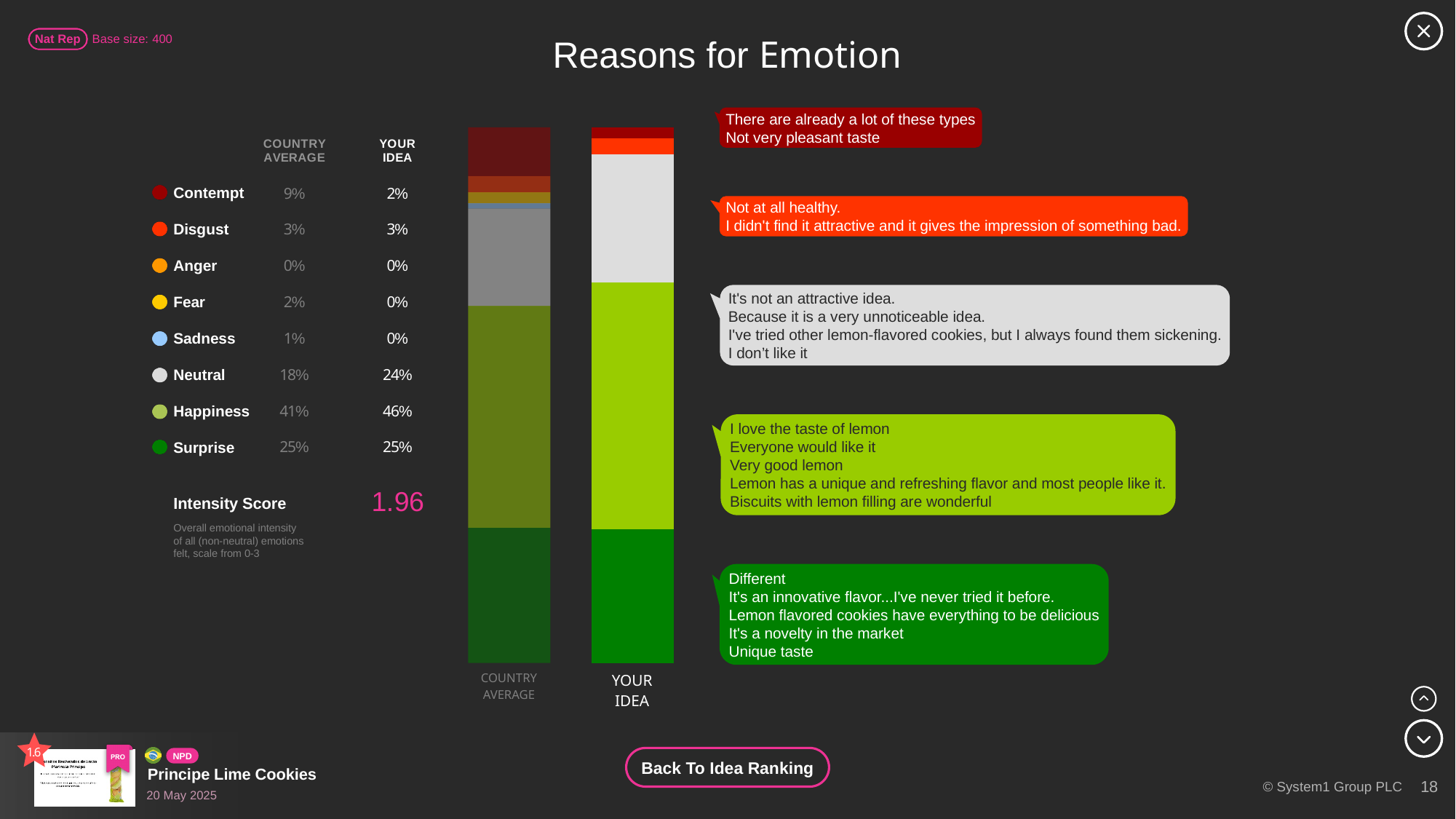
What is the Neutral value for the Country Average? 18% How many emotion categories are listed in the chart? 8 Which emotion has the highest value for Your Idea? Happiness What percentage of respondents felt Happiness for Your Idea? 46% What kind of chart is shown on the slide? Stacked bar chart How many stacked bars are shown in the chart? 2 What is the difference between the Neutral value for Your Idea and the Country Average? 6 percentage points What is the Intensity Score shown on the slide? 1.96 Is the Happiness value larger for Your Idea or for the Country Average? Your Idea Is the Contempt value larger for the Country Average or for Your Idea? Country Average What is the Country Average value for Contempt? 9% What is the Surprise value for Your Idea? 25%